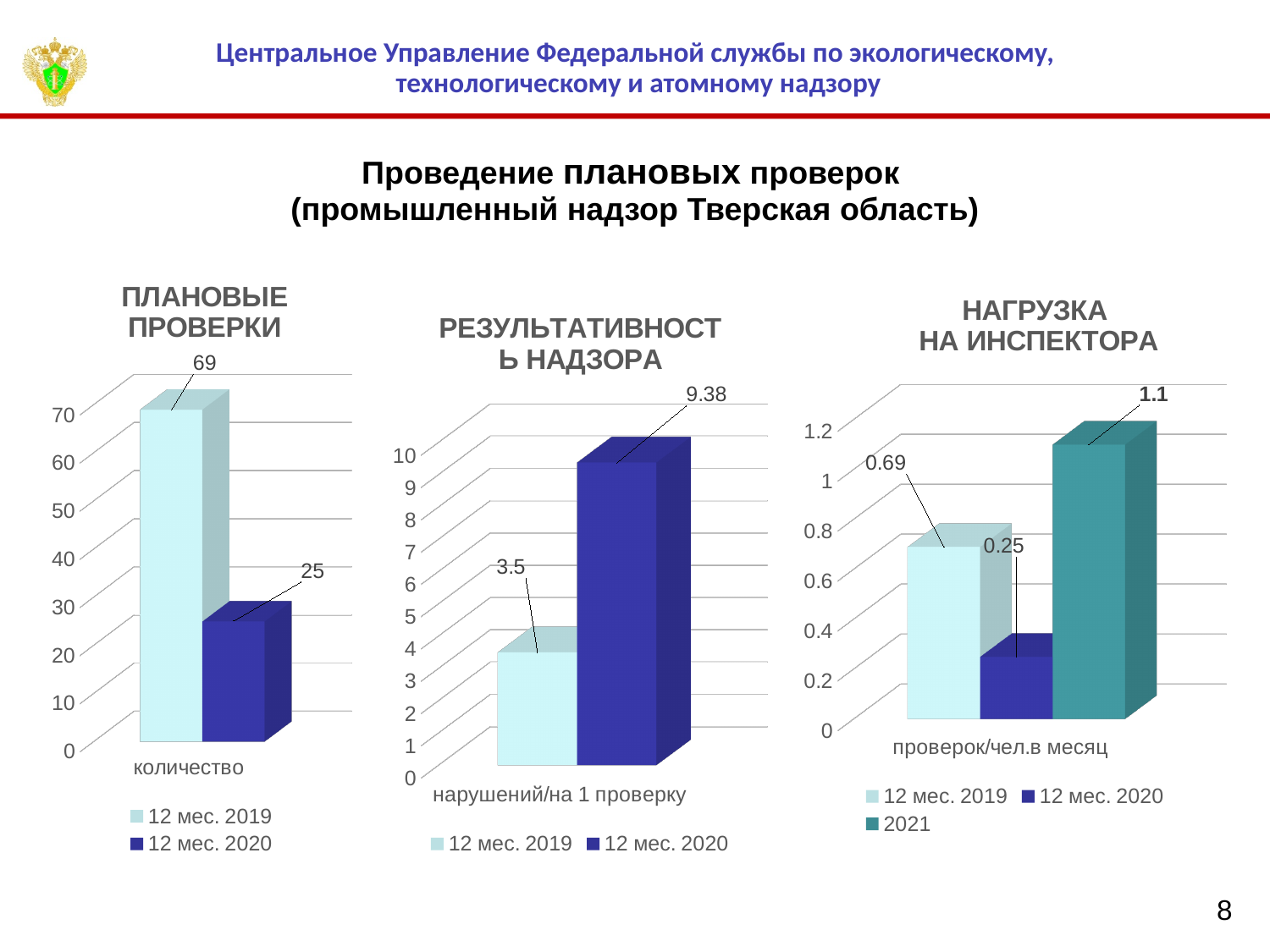
In the 'ПЛАНОВЫЕ ПРОВЕРКИ' chart, what is the difference between the 12 мес. 2019 and 12 мес. 2020 values? 44 In the 'НАГРУЗКА НА ИНСПЕКТОРА' chart, which series has the highest value? 2021 In the 'НАГРУЗКА НА ИНСПЕКТОРА' chart, what is the value for 2021? 1.1 What is the x-axis category label in the 'НАГРУЗКА НА ИНСПЕКТОРА' chart? проверок/чел.в месяц In the 'ПЛАНОВЫЕ ПРОВЕРКИ' chart, what is the value for 12 мес. 2020? 25 In the 'РЕЗУЛЬТАТИВНОСТЬ НАДЗОРА' chart, what is the value for 12 мес. 2020? 9.38 In the 'РЕЗУЛЬТАТИВНОСТЬ НАДЗОРА' chart, how many series does the legend list? 2 In the 'ПЛАНОВЫЕ ПРОВЕРКИ' chart, what is the value for 12 мес. 2019? 69 What kind of chart is the 'ПЛАНОВЫЕ ПРОВЕРКИ' chart? Bar chart In the 'НАГРУЗКА НА ИНСПЕКТОРА' chart, how many series does the legend list? 3 In the 'НАГРУЗКА НА ИНСПЕКТОРА' chart, which series has the lowest value? 12 мес. 2020 In the 'РЕЗУЛЬТАТИВНОСТЬ НАДЗОРА' chart, which series has the higher value, 12 мес. 2019 or 12 мес. 2020? 12 мес. 2020